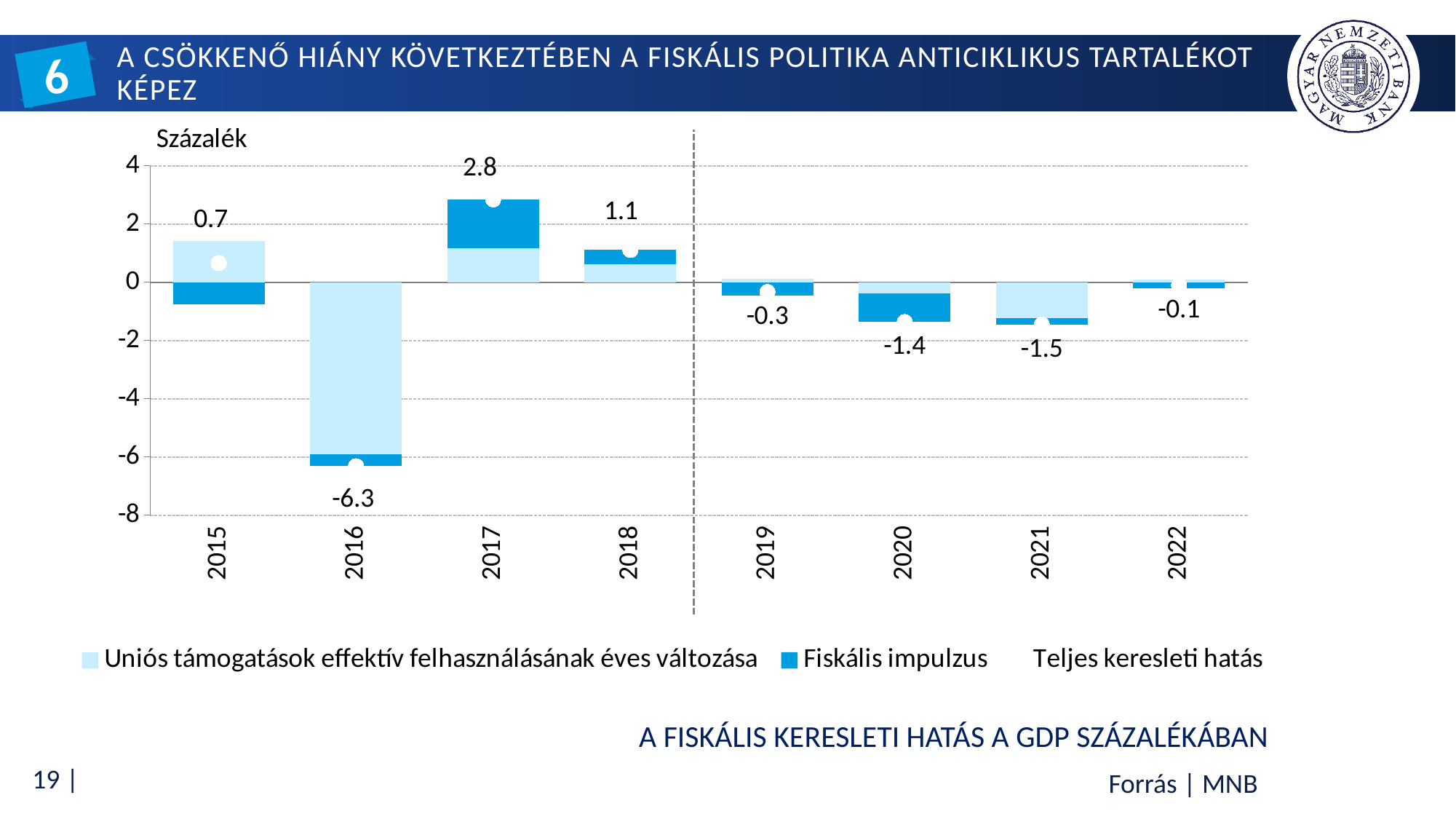
What is the value of Teljes keresleti hatás for 2016? -6.3 Which is larger, the Teljes keresleti hatás value for 2015 or for 2018? 2018 Is the Uniós támogatások effektív felhasználásának éves változása bar for 2016 greater or less than -4? less What is the difference between the Teljes keresleti hatás values for 2017 and 2018? 1.7 What is the value of Teljes keresleti hatás for 2017? 2.8 What is the value of Teljes keresleti hatás for 2021? -1.5 Which year has the lowest Teljes keresleti hatás value? 2016 What is the value of Teljes keresleti hatás for 2022? -0.1 How many series does the legend list? 3 How many years are shown on the x axis? 8 What unit label is shown above the vertical axis? Százalék Which year has the highest Teljes keresleti hatás value? 2017